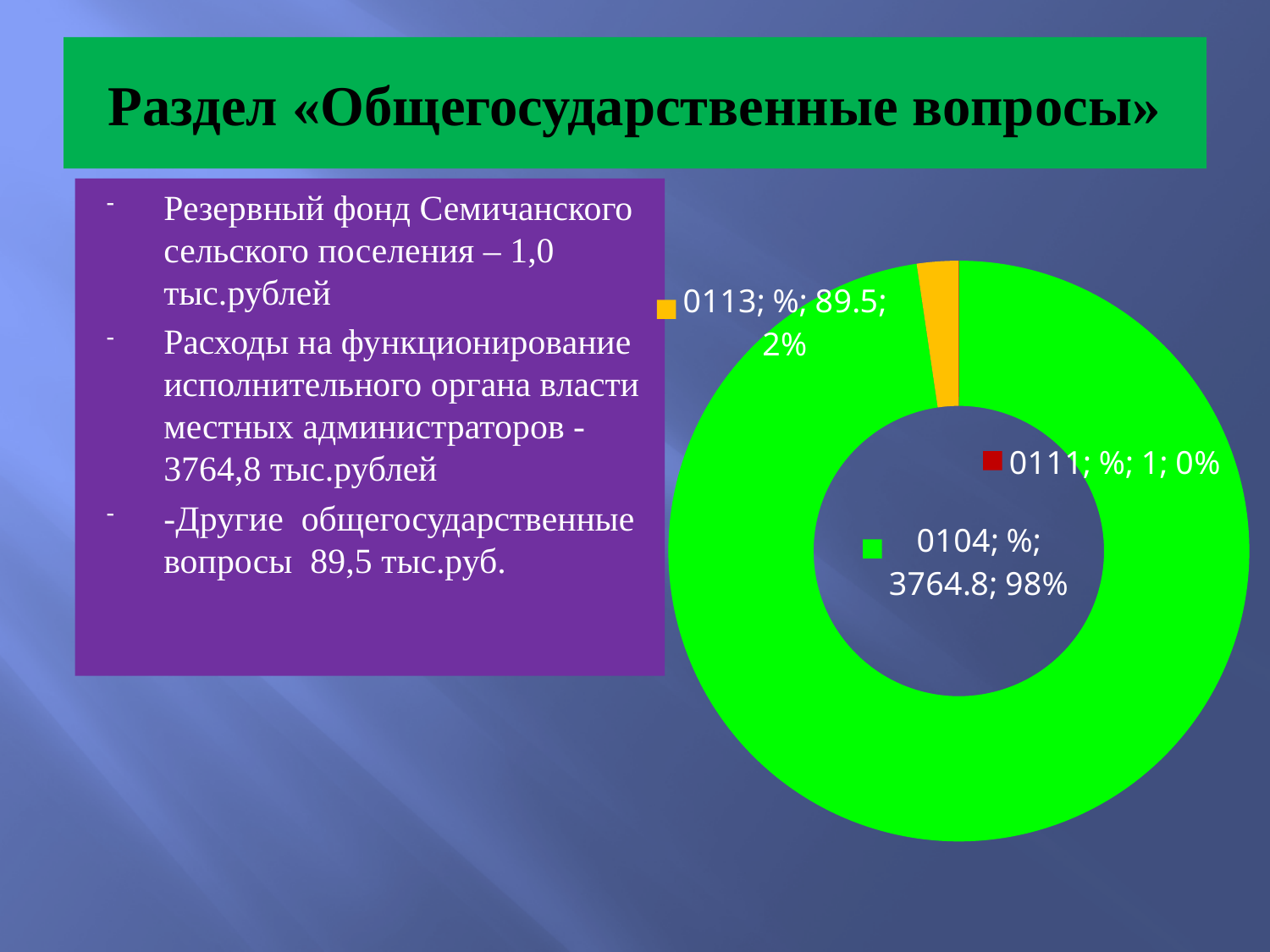
What is the value shown for category 0104? 3764.8 What is the difference between the values for 0104 and 0113? 3675.3 What is the value shown for category 0113? 89.5 What colour is the slice for category 0104? green Which category has the largest slice of the doughnut chart? 0104 What kind of chart is shown on the slide? doughnut chart Which is larger, the value for 0113 or the value for 0111? 0113 What share of the doughnut chart does category 0104 represent? 98% How many categories does the doughnut chart show? 3 Which category has the smallest slice of the doughnut chart? 0111 What is the value shown for category 0111? 1 What share of the doughnut chart does category 0113 represent? 2%